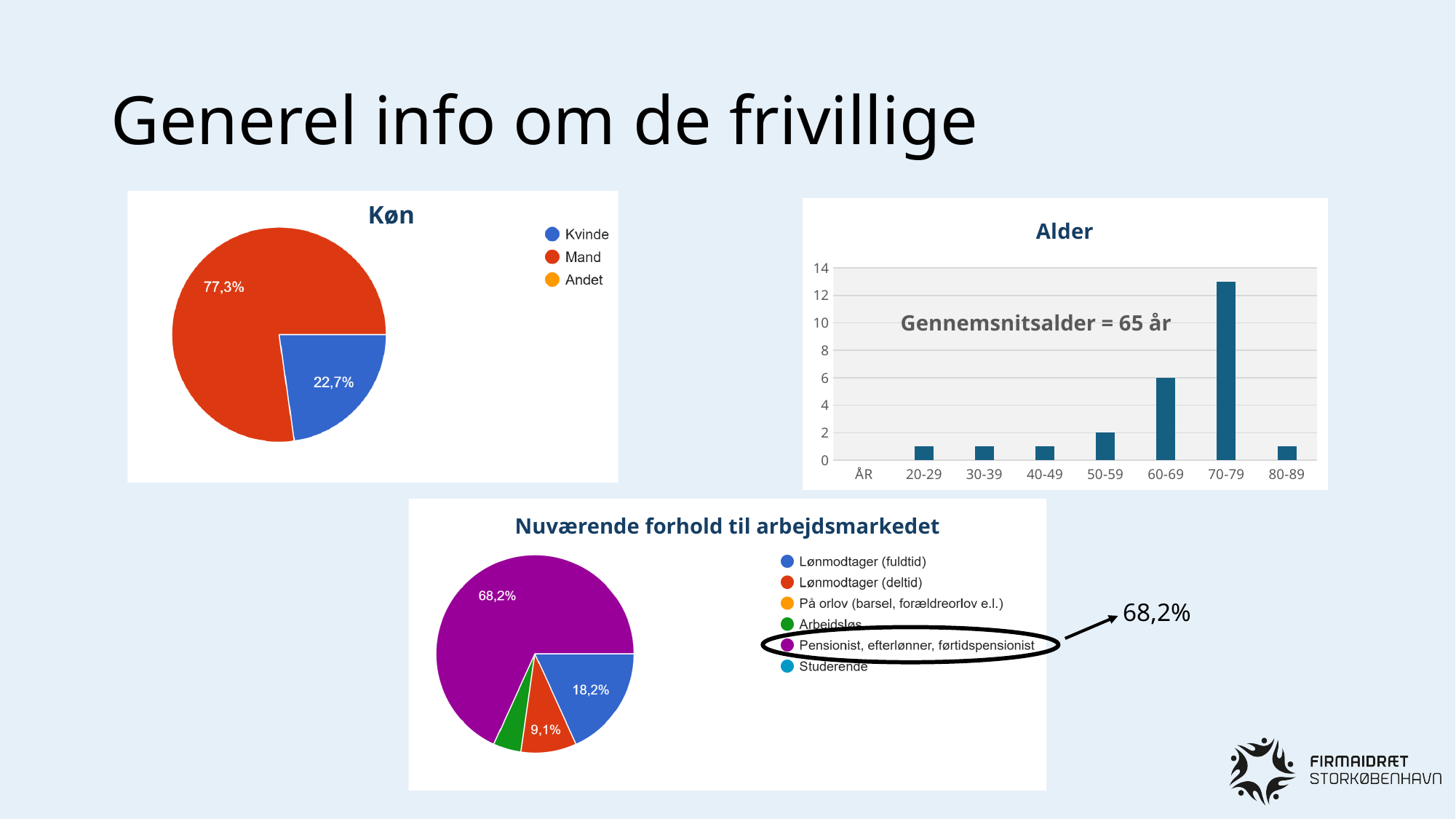
In the 'Alder' chart, which age group has the highest bar? 70-79 In the 'Alder' chart, what is the value for the 50-59 age group? 2 What kind of chart is the 'Alder' chart? Bar chart In the 'Nuværende forhold til arbejdsmarkedet' pie chart, what share is labelled for Lønmodtager (fuldtid)? 18,2% In the 'Alder' chart, what average age is stated in the text inside the plot area? 65 år In the 'Køn' pie chart, how many entries does the legend list? 3 In the 'Alder' chart, is the value for 70-79 greater or less than 12? greater In the 'Køn' pie chart, what share is labelled for Kvinde? 22,7% In the 'Køn' pie chart, which is larger, the Mand slice or the Kvinde slice? Mand In the 'Køn' pie chart, what share is labelled for Mand? 77,3% In the 'Alder' chart, what is the value for the 60-69 age group? 6 In the 'Køn' chart, what is the difference between the Mand share and the Kvinde share? 54,6 percentage points